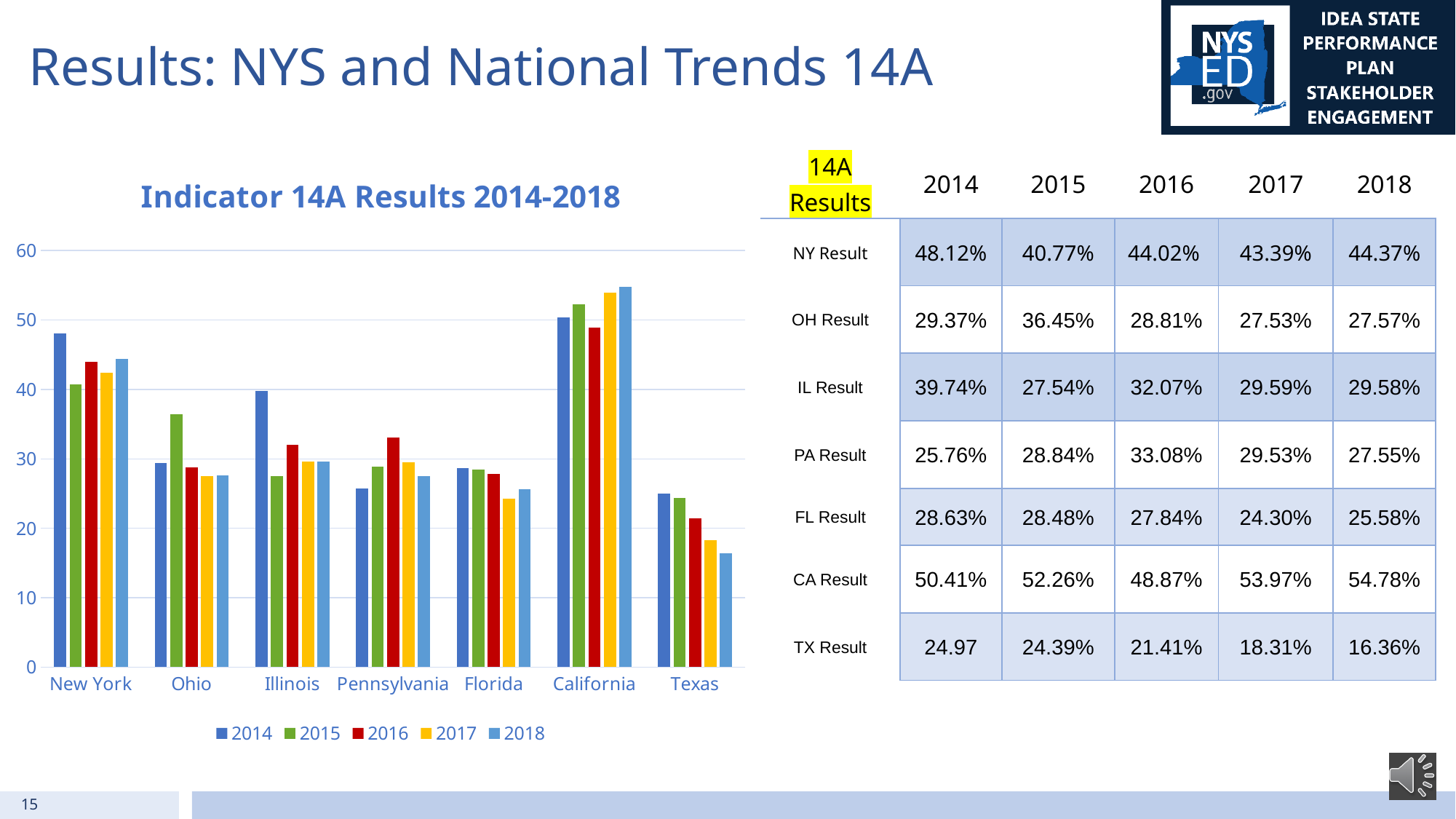
Do the values for Texas rise or fall from 2014 to 2018? fall What is the title of the chart? Indicator 14A Results 2014-2018 Is the 2018 value for Texas in the chart greater or less than 20? less Is the 2015 value for Ohio in the chart greater or less than 30? greater According to the table, what is the NY Result for 2014? 48.12% According to the table, what is the CA Result for 2018? 54.78% Which state has the lowest 2018 value in the chart? Texas What type of chart is shown on the slide? bar chart How many states are shown on the x axis of the chart? 7 How many series does the chart legend list? 5 Which state has the highest 2018 value in the chart? California Using the table, what is the difference between the NY Result and the OH Result for 2018? 16.80%